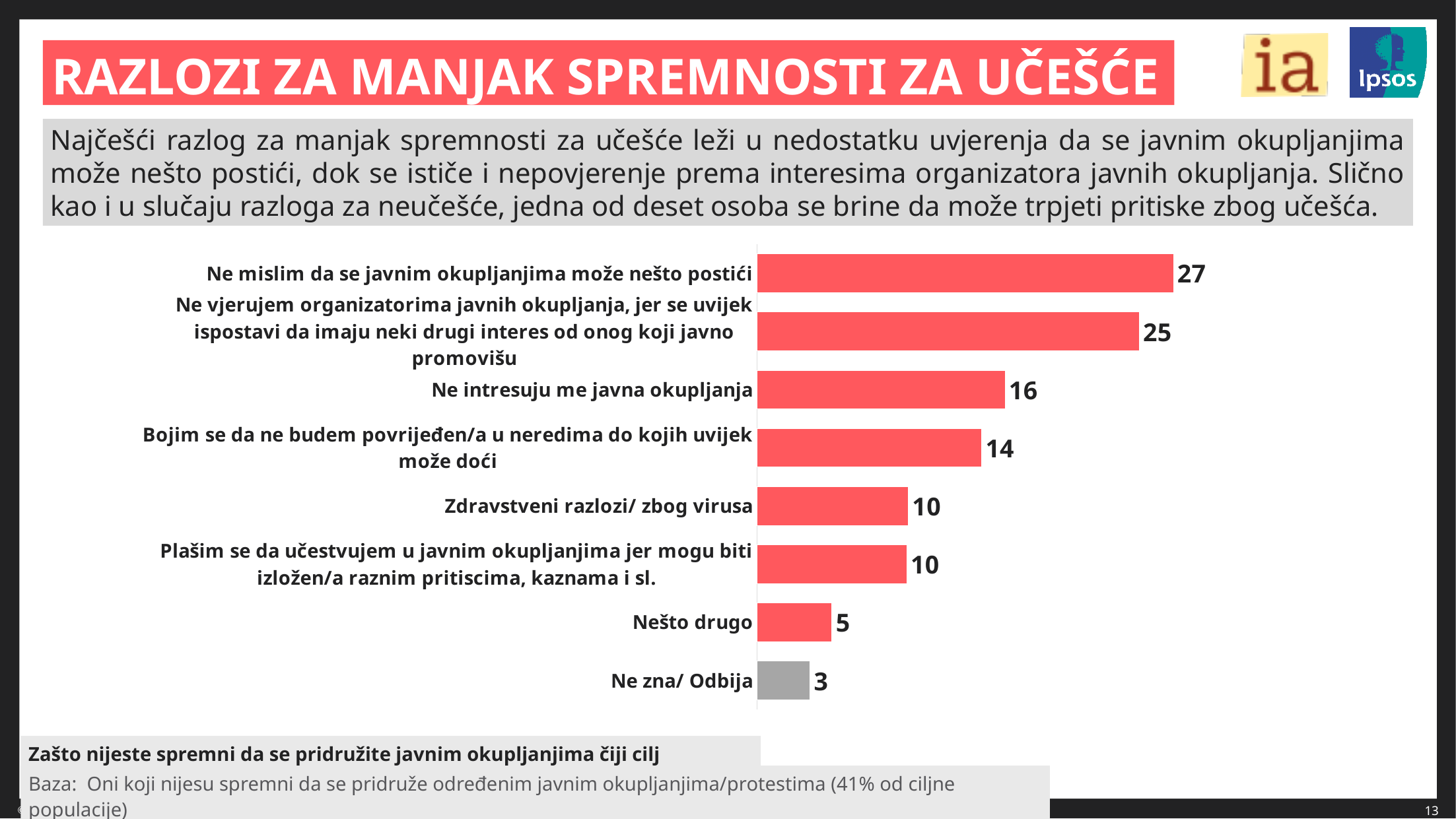
How many categories are shown in the chart? 8 What kind of chart is shown on the slide? Bar chart What is the difference between the values for "Ne mislim da se javnim okupljanjima može nešto postići" and "Ne intresuju me javna okupljanja"? 11 What is the value for "Ne mislim da se javnim okupljanjima može nešto postići"? 27 What is the value for "Ne zna/ Odbija"? 3 Which category has the highest value? Ne mislim da se javnim okupljanjima može nešto postići Which is larger: the value for "Bojim se da ne budem povrijeđen/a u neredima do kojih uvijek može doći" or the value for "Nešto drugo"? Bojim se da ne budem povrijeđen/a u neredima do kojih uvijek može doći What is the value for "Ne intresuju me javna okupljanja"? 16 What is the value for "Zdravstveni razlozi/ zbog virusa"? 10 What is the difference between the values for "Ne vjerujem organizatorima javnih okupljanja..." and "Bojim se da ne budem povrijeđen/a u neredima..."? 11 Which bar is coloured grey rather than red? Ne zna/ Odbija Which category has the lowest value? Ne zna/ Odbija